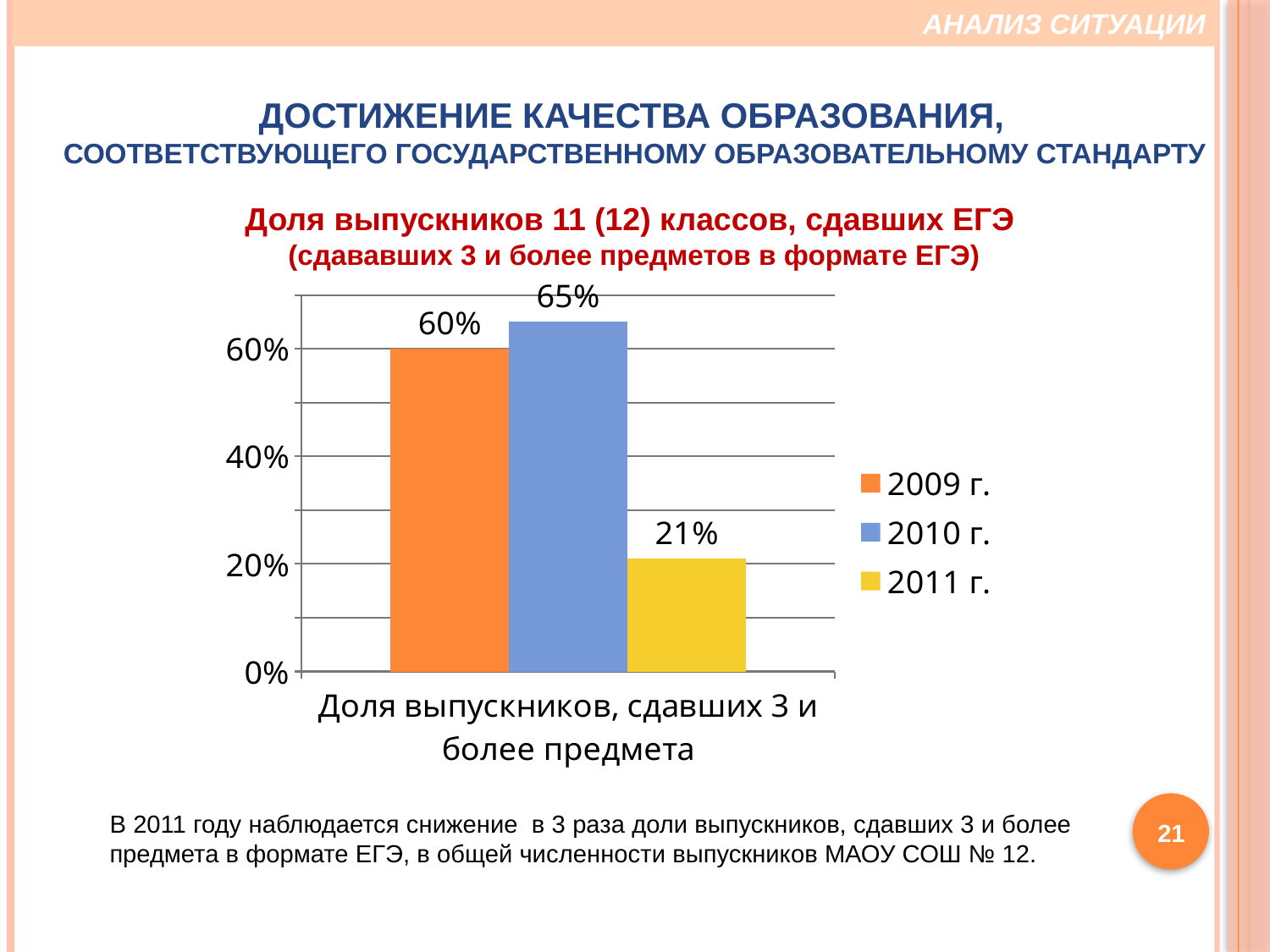
Is the value for 2011 г. greater or less than 40%? less Which year has the lowest share of graduates who passed 3 or more subjects? 2011 г. What is the value for 2009 г.? 60% What is the value for 2011 г.? 21% What kind of chart is shown on the slide? bar chart What is the value for 2010 г.? 65% What is the difference between the values for 2010 г. and 2009 г.? 5% Which year has the highest share of graduates who passed 3 or more subjects? 2010 г. What is the difference between the values for 2010 г. and 2011 г.? 44% How many series does the legend list? 3 Which is larger, the value for 2009 г. or the value for 2011 г.? 2009 г. What colour is the bar for 2011 г.? yellow